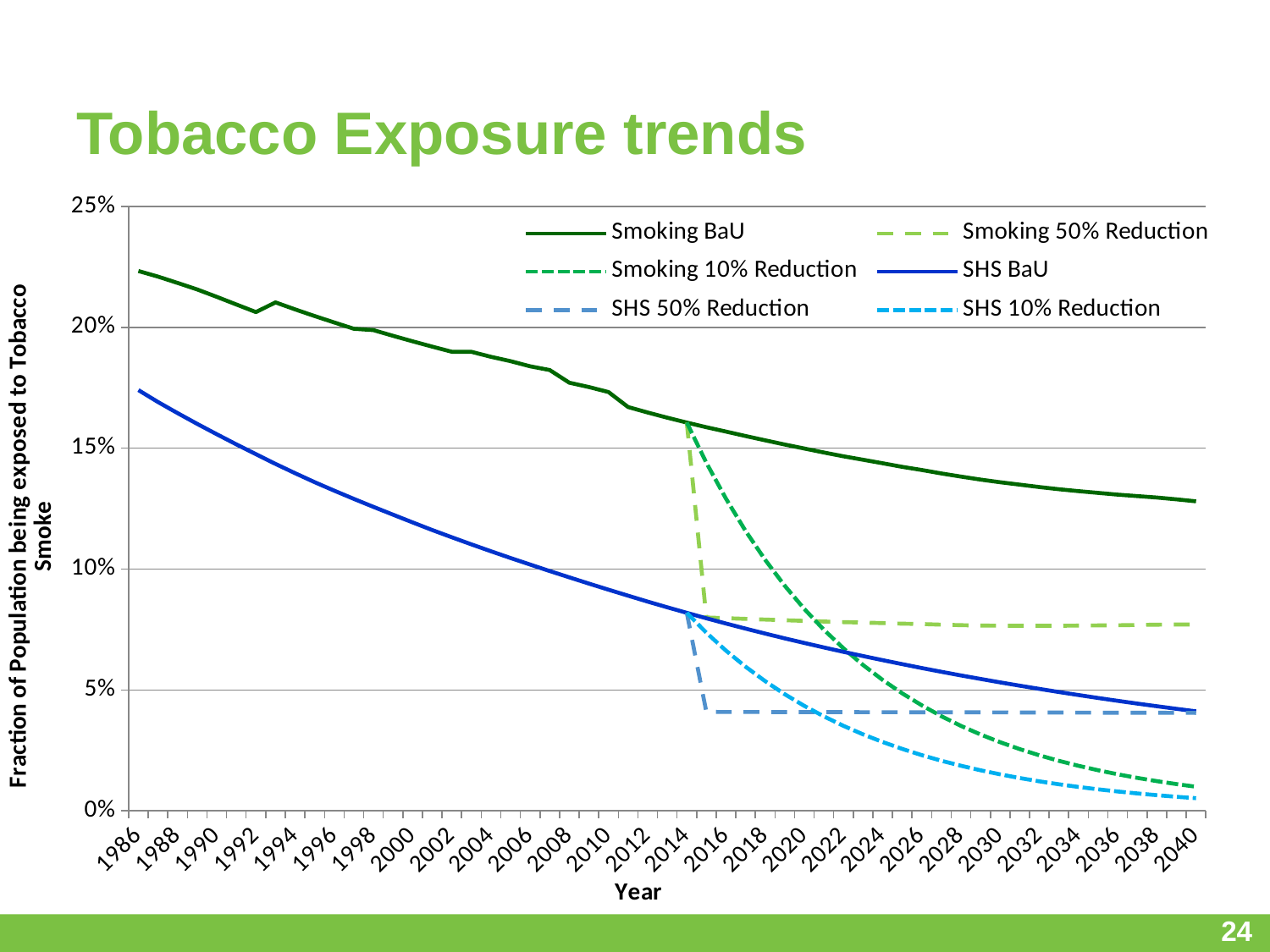
Is the value for Smoking BaU in 2040 greater or less than 10%? greater How many series does the legend list? 6 Is the value for Smoking BaU in 1986 greater or less than 20%? greater In 2040, which is larger: Smoking BaU or SHS BaU? Smoking BaU In 2030, which is larger: Smoking 50% Reduction or SHS 50% Reduction? Smoking 50% Reduction Does the Smoking BaU series rise or fall from 1986 to 2040? Fall Is the value for SHS BaU in 2040 greater or less than 5%? less What is the label of the x axis? Year What kind of chart is shown on the slide? Line chart What is the title of the chart? Tobacco Exposure trends